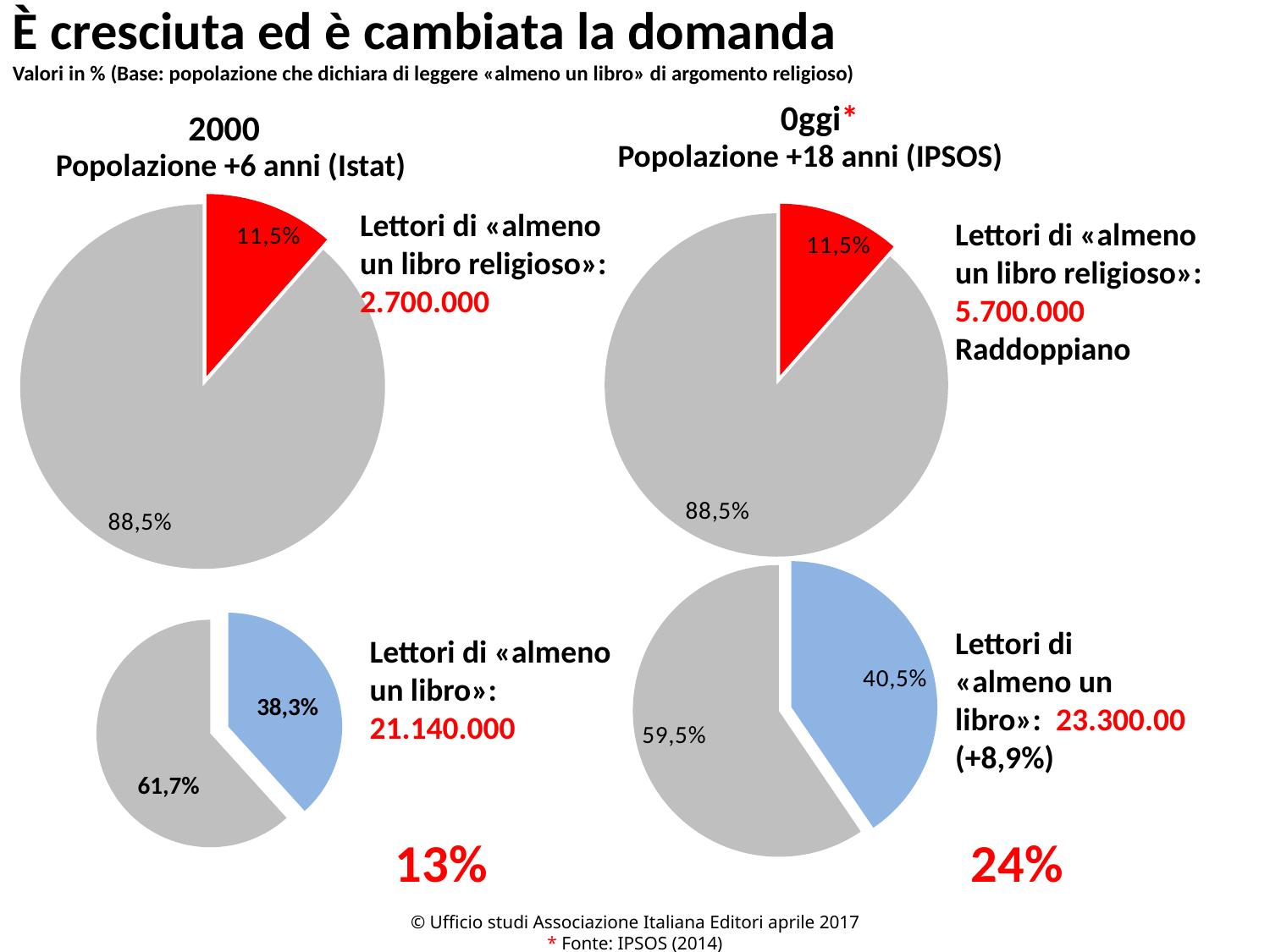
In the top-left pie chart (2000, Popolazione +6 anni), what percentage does the grey slice show? 88,5% In the top-right pie chart (Oggi, Popolazione +18 anni), what percentage does the red slice show? 11,5% In the bottom-right pie chart, what percentage does the grey slice show? 59,5% In the bottom-right pie chart, which slice is larger, the blue one or the grey one? the grey one In the bottom-left pie chart, what percentage does the grey slice show? 61,7% In the top-left pie chart (2000, Popolazione +6 anni), what percentage does the red slice show? 11,5% What is the difference between the blue slice of the bottom-right pie chart (40,5%) and the blue slice of the bottom-left pie chart (38,3%)? 2,2 percentage points What kind of chart is used in the top-left chart under "2000 Popolazione +6 anni (Istat)"? pie chart How many slices does the top-right pie chart (Oggi, Popolazione +18 anni) have? 2 How many pie charts are shown on the slide? 4 In the bottom-right pie chart, what percentage does the blue slice show? 40,5% In the bottom-left pie chart, what percentage does the blue slice show? 38,3%